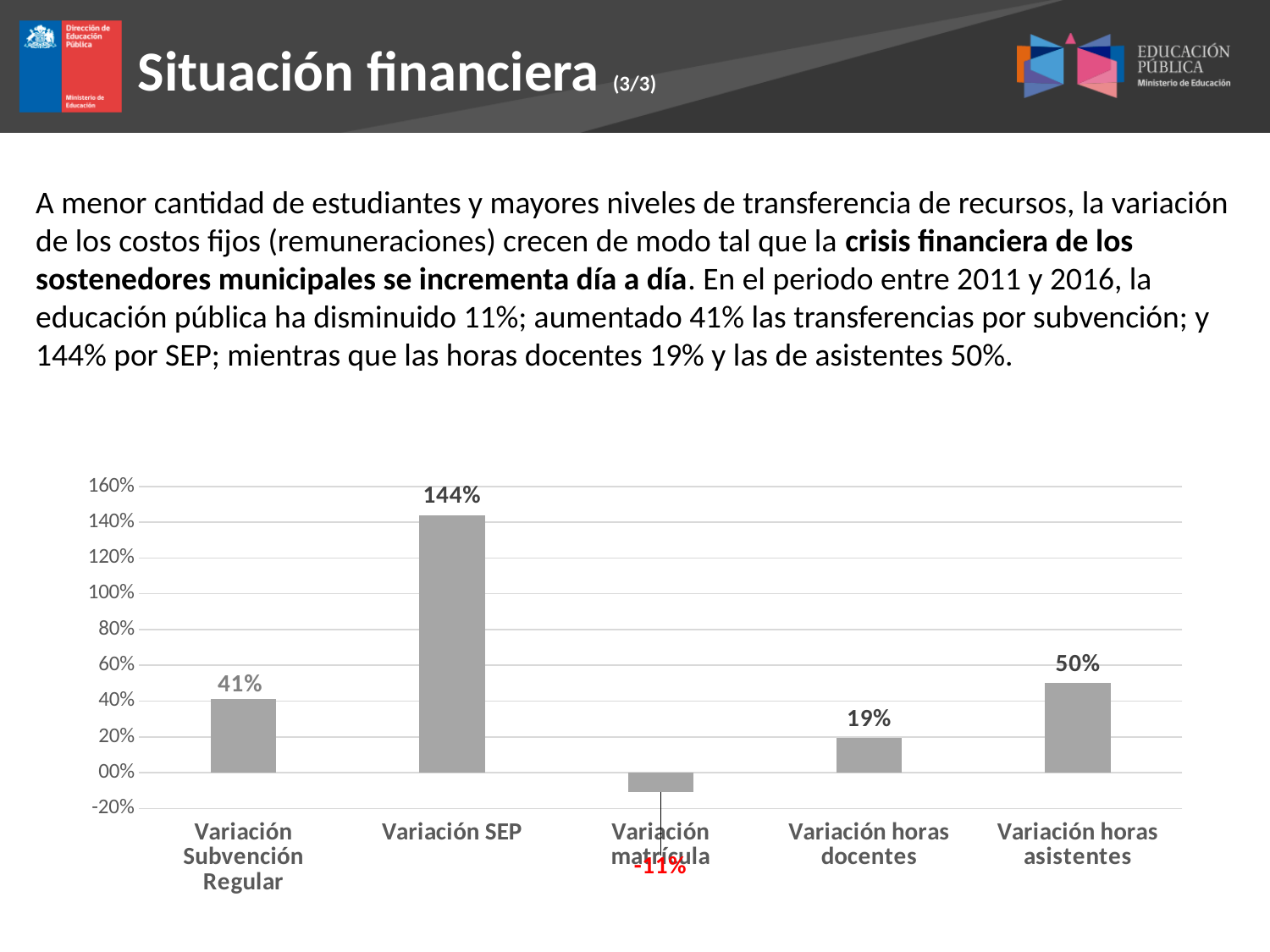
Is the value for Variación SEP greater or less than 100%? greater Which category has the lowest value? Variación matrícula What is the value for Variación horas docentes? 19% What is the value for Variación horas asistentes? 50% Which category has the highest value? Variación SEP What is the value for Variación SEP? 144% Which is larger, Variación horas asistentes or Variación horas docentes? Variación horas asistentes What is the difference between Variación SEP and Variación Subvención Regular? 103% What is the value for Variación Subvención Regular? 41% How many categories are shown in the chart? 5 What kind of chart is shown on the slide? bar chart What is the value for Variación matrícula? -11%